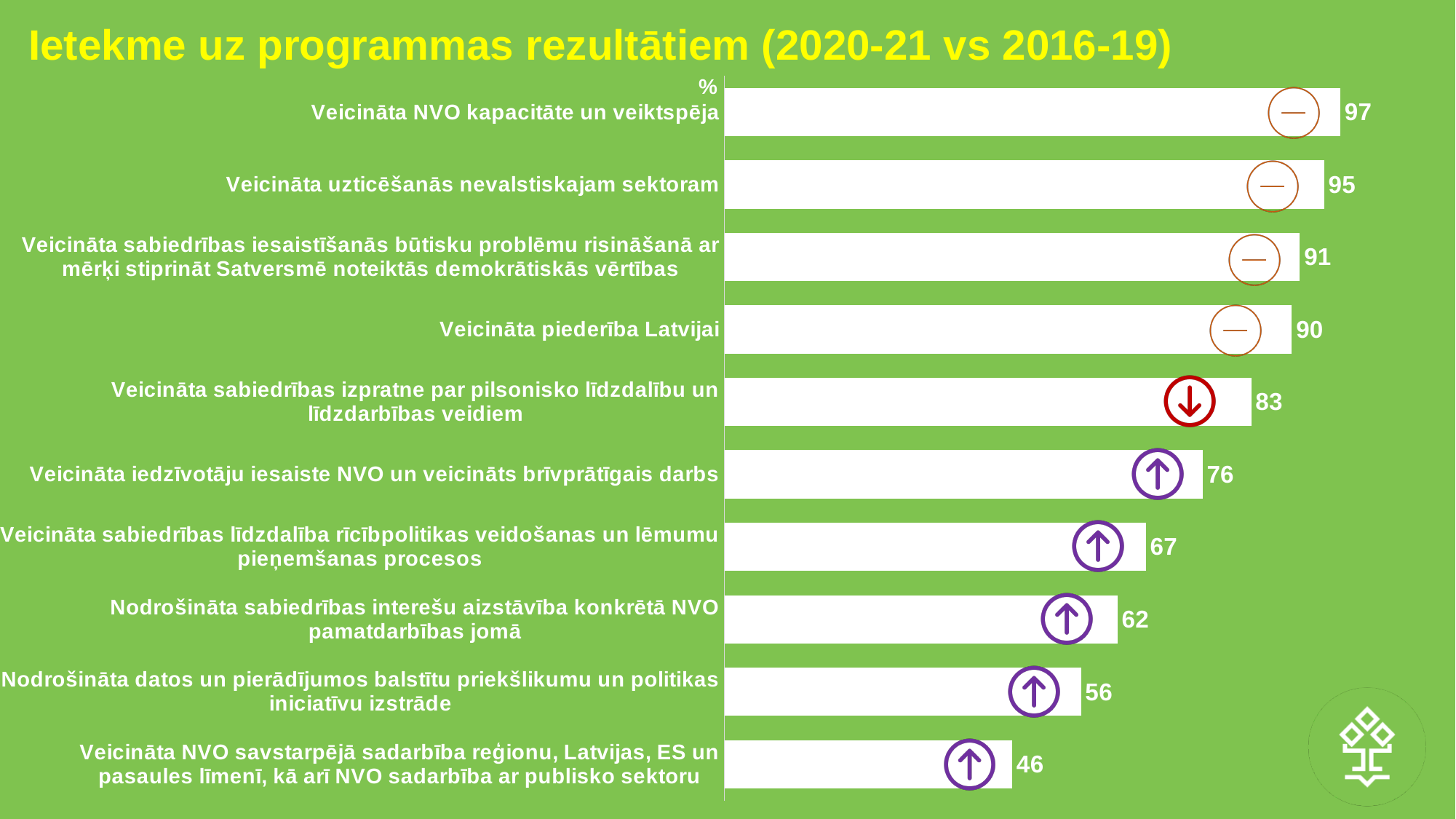
Which category has the highest value? Veicināta NVO kapacitāte un veiktspēja What is the difference between the values for "Veicināta uzticēšanās nevalstiskajam sektoram" and "Veicināta sabiedrības izpratne par pilsonisko līdzdalību un līdzdarbības veidiem"? 12 What unit is indicated at the top of the bars? % What is the value for "Veicināta NVO kapacitāte un veiktspēja"? 97 What is the value for "Veicināta piederība Latvijai"? 90 What kind of chart is shown on the slide? Bar chart What is the value for "Veicināta sabiedrības līdzdalība rīcībpolitikas veidošanas un lēmumu pieņemšanas procesos"? 67 What is the value for "Veicināta iedzīvotāju iesaiste NVO un veicināts brīvprātīgais darbs"? 76 What is the title of the slide? Ietekme uz programmas rezultātiem (2020-21 vs 2016-19) How many categories are shown in the chart? 10 Which is larger: the value for "Nodrošināta sabiedrības interešu aizstāvība konkrētā NVO pamatdarbības jomā" or for "Nodrošināta datos un pierādījumos balstītu priekšlikumu un politikas iniciatīvu izstrāde"? Nodrošināta sabiedrības interešu aizstāvība konkrētā NVO pamatdarbības jomā Which category has the lowest value? Veicināta NVO savstarpējā sadarbība reģionu, Latvijas, ES un pasaules līmenī, kā arī NVO sadarbība ar publisko sektoru